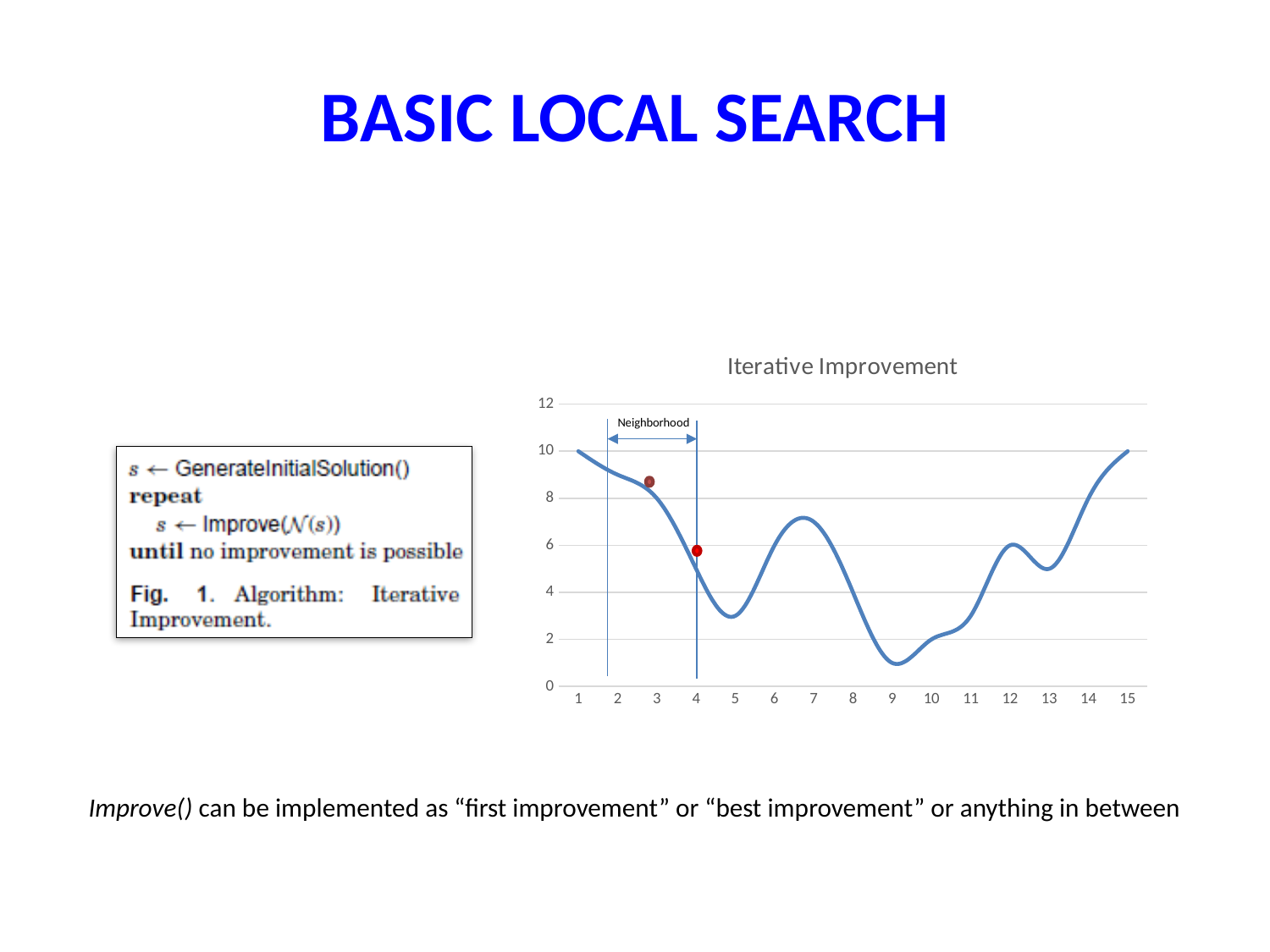
What kind of chart is shown on the slide? line chart Is the value of the line at x = 5 greater or less than 4? less What is the value of the line at x = 1? 10 At which x value does the line reach its lowest point? 9 Is the value of the line at x = 7 greater or less than 6? greater What is the value of the line at x = 15? 10 What is the title of the chart? Iterative Improvement What label is written between the two vertical lines near the top left of the chart? Neighborhood Is the value of the line at x = 2 greater or less than 8? greater Does the line rise or fall between x = 1 and x = 9? fall How many points are labelled along the x axis of the chart? 15